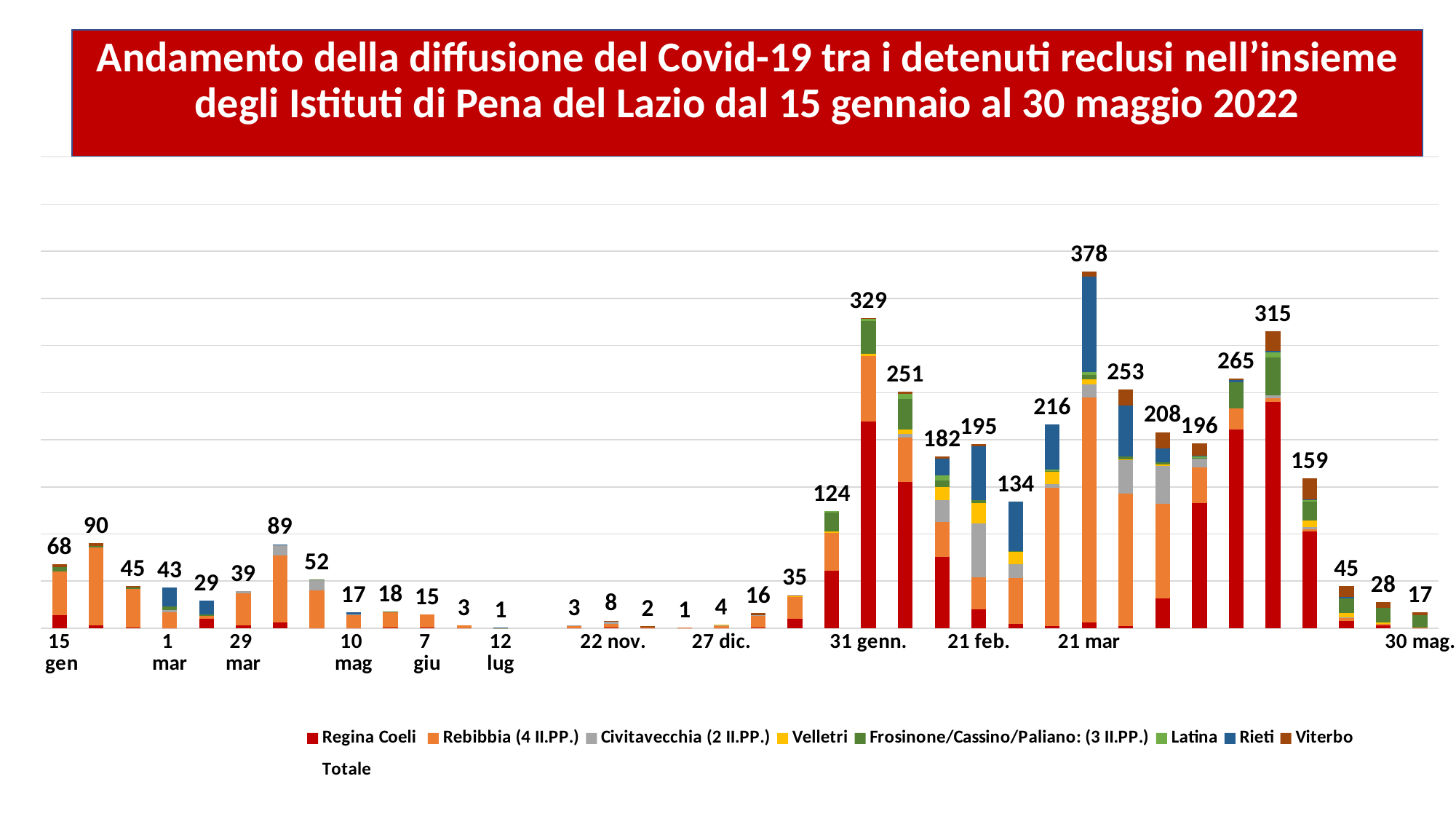
Which date has the highest total value? 21 mar What is the total value shown for 31 genn.? 329 What is the total value shown for 15 gen? 68 Which has a larger total, 21 feb. or 1 mar? 21 feb. What is the difference between the totals for 21 mar and 31 genn.? 49 How many entries does the legend list? 9 What is the total value shown for 21 mar? 378 What is the total value shown for 30 mag.? 17 What is the total value shown for 27 dic.? 4 What is the total value shown for 22 nov.? 8 What kind of chart is shown on the slide? Stacked bar chart What is the difference between the totals for 31 genn. and 21 feb.? 134